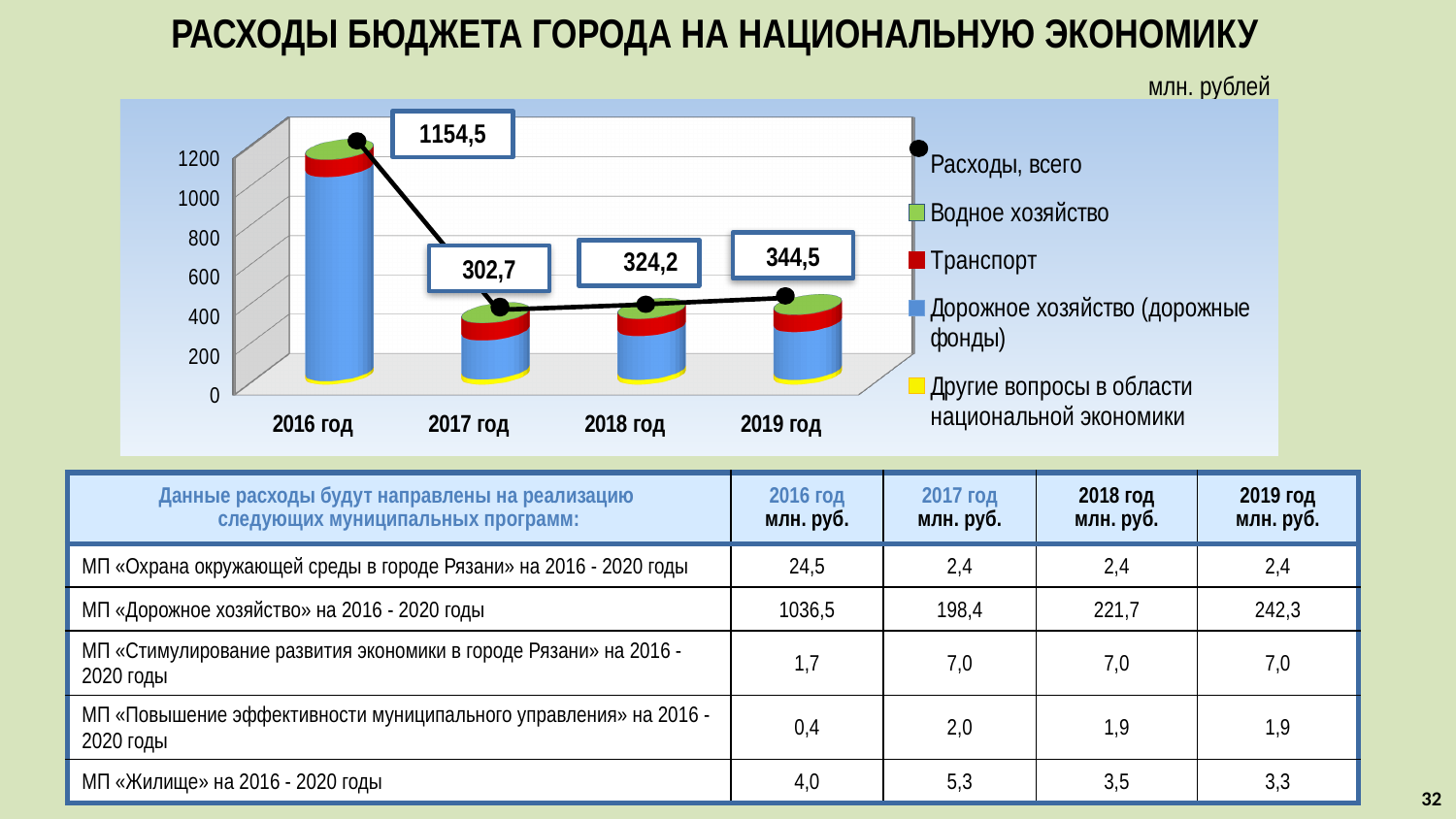
What is the value of «Расходы, всего» for 2018 год? 324,2 What is the value of «Расходы, всего» for 2017 год? 302,7 In which year is «Расходы, всего» the lowest? 2017 год What is the value of «Расходы, всего» for 2019 год? 344,5 What is the difference in «Расходы, всего» between 2019 год and 2018 год? 20,3 In which year is «Расходы, всего» the highest? 2016 год How many years are shown on the x axis of the chart? 4 Which year has the larger «Расходы, всего»: 2018 год or 2019 год? 2019 год Is the value of «Расходы, всего» for 2016 год greater or less than 1000? greater By how much did «Расходы, всего» fall from 2016 год to 2017 год? 851,8 How many entries does the chart legend list? 5 What is the value of «Расходы, всего» for 2016 год? 1154,5